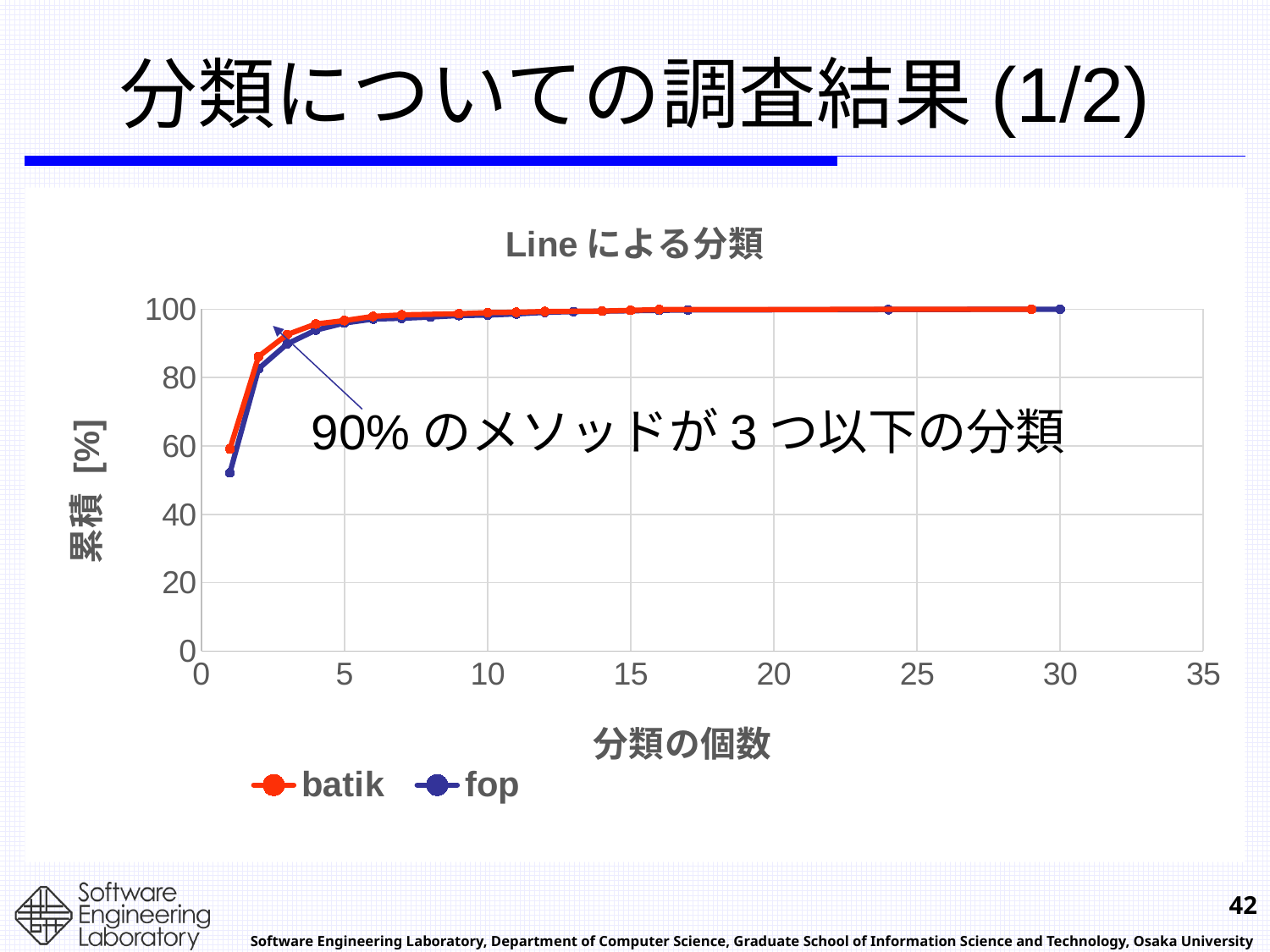
What are the names of the two series in the legend? batik and fop At 1 on the x axis, which series has the higher value, batik or fop? batik Do the values for batik rise or fall as the number of categories (分類の個数) increases? rise Is the value for batik at 5 on the x axis greater or less than 80? greater Is the value for fop at 1 on the x axis greater or less than 60? less What kind of chart is shown on the slide? line chart Is the value for fop at 3 on the x axis greater or less than 80? greater Do the values for fop rise or fall along the x axis? rise How many series does the legend list? 2 At 2 on the x axis, which series has the higher value, batik or fop? batik What is the title of the chart? Line による分類